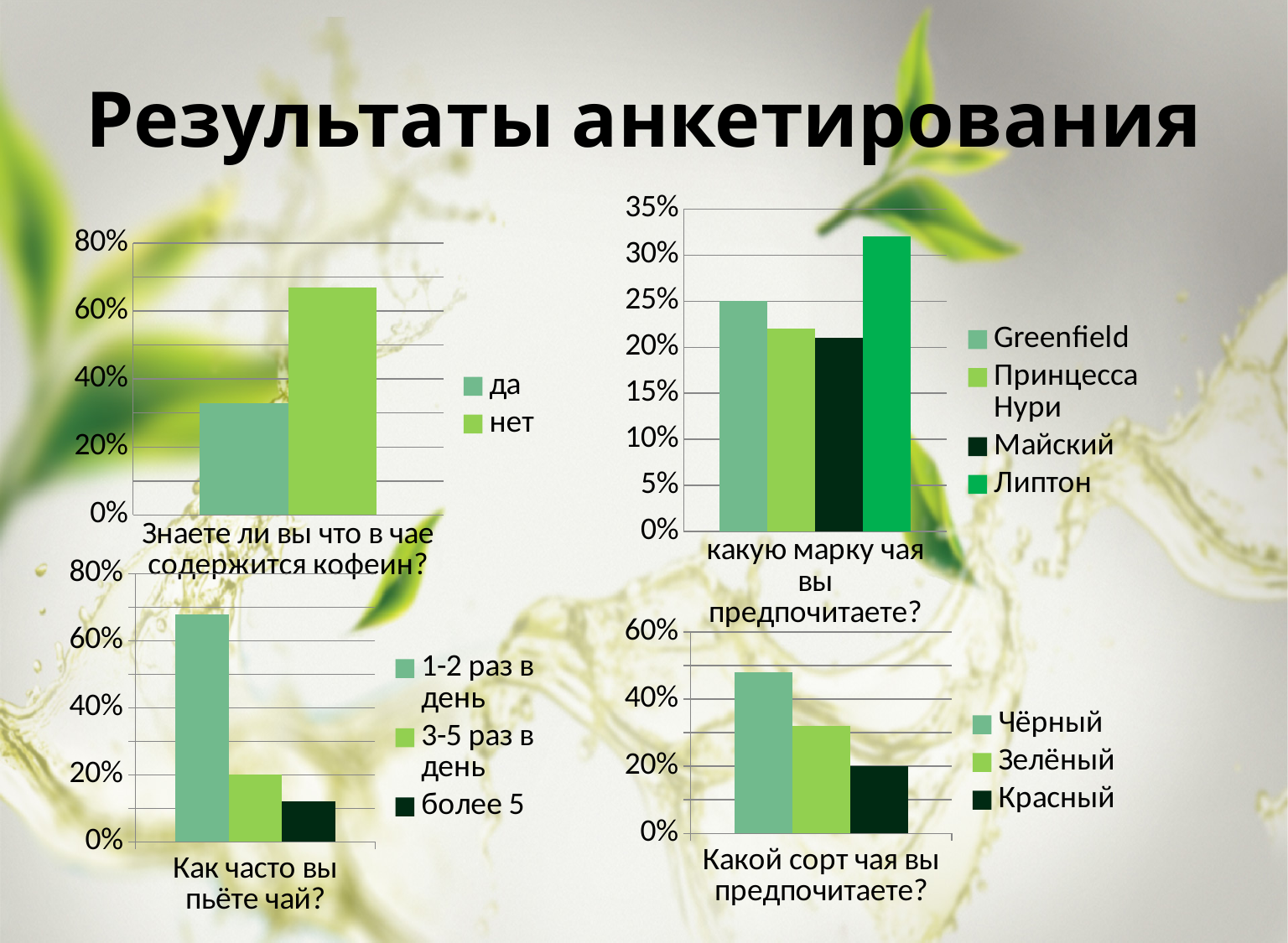
In the chart labelled "Знаете ли вы что в чае содержится кофеин?", which is larger, да or нет? нет In the chart labelled "Как часто вы пьёте чай?", what is the value for 3-5 раз в день? 20% In the chart labelled "Какой сорт чая вы предпочитаете?", what is the value for Красный? 20% In the chart labelled "какую марку чая вы предпочитаете?", which brand has the highest value? Липтон How many series does the legend list in the chart labelled "какую марку чая вы предпочитаете?"? 4 What kind of chart is the chart labelled "какую марку чая вы предпочитаете?"? bar chart In the chart labelled "Как часто вы пьёте чай?", which category has the lowest value? более 5 In the chart labelled "какую марку чая вы предпочитаете?", what is the value for Greenfield? 25% In the chart labelled "Какой сорт чая вы предпочитаете?", which tea type has the highest value? Чёрный In the chart labelled "какую марку чая вы предпочитаете?", is the value for Липтон greater or less than 30%? greater How many charts are on the slide? 4 In the chart labelled "Знаете ли вы что в чае содержится кофеин?", is the value for нет greater or less than 60%? greater